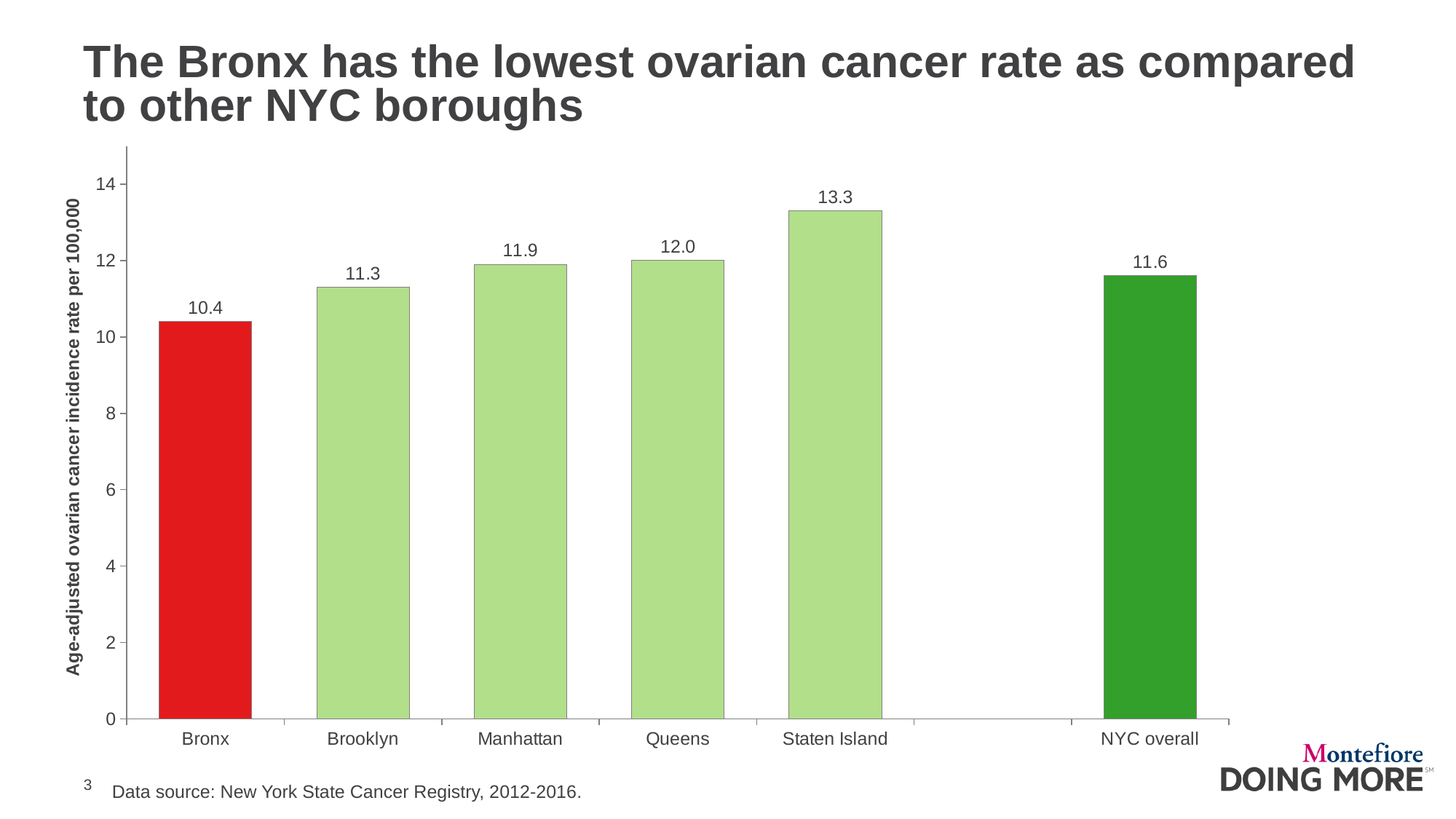
What kind of chart is shown on the slide? Bar chart What is the difference between the ovarian cancer incidence rates of Staten Island and the Bronx? 2.9 How many bars are shown in the chart? 6 What is the age-adjusted ovarian cancer incidence rate per 100,000 for the Bronx? 10.4 What is the age-adjusted ovarian cancer incidence rate per 100,000 for Staten Island? 13.3 What is the age-adjusted ovarian cancer incidence rate per 100,000 for NYC overall? 11.6 Which category has the lowest ovarian cancer incidence rate? Bronx What is the difference between the ovarian cancer incidence rates of NYC overall and the Bronx? 1.2 What colour is the bar for the Bronx? Red What is the age-adjusted ovarian cancer incidence rate per 100,000 for Manhattan? 11.9 Which has a higher ovarian cancer incidence rate, Brooklyn or Queens? Queens Which category has the highest ovarian cancer incidence rate? Staten Island